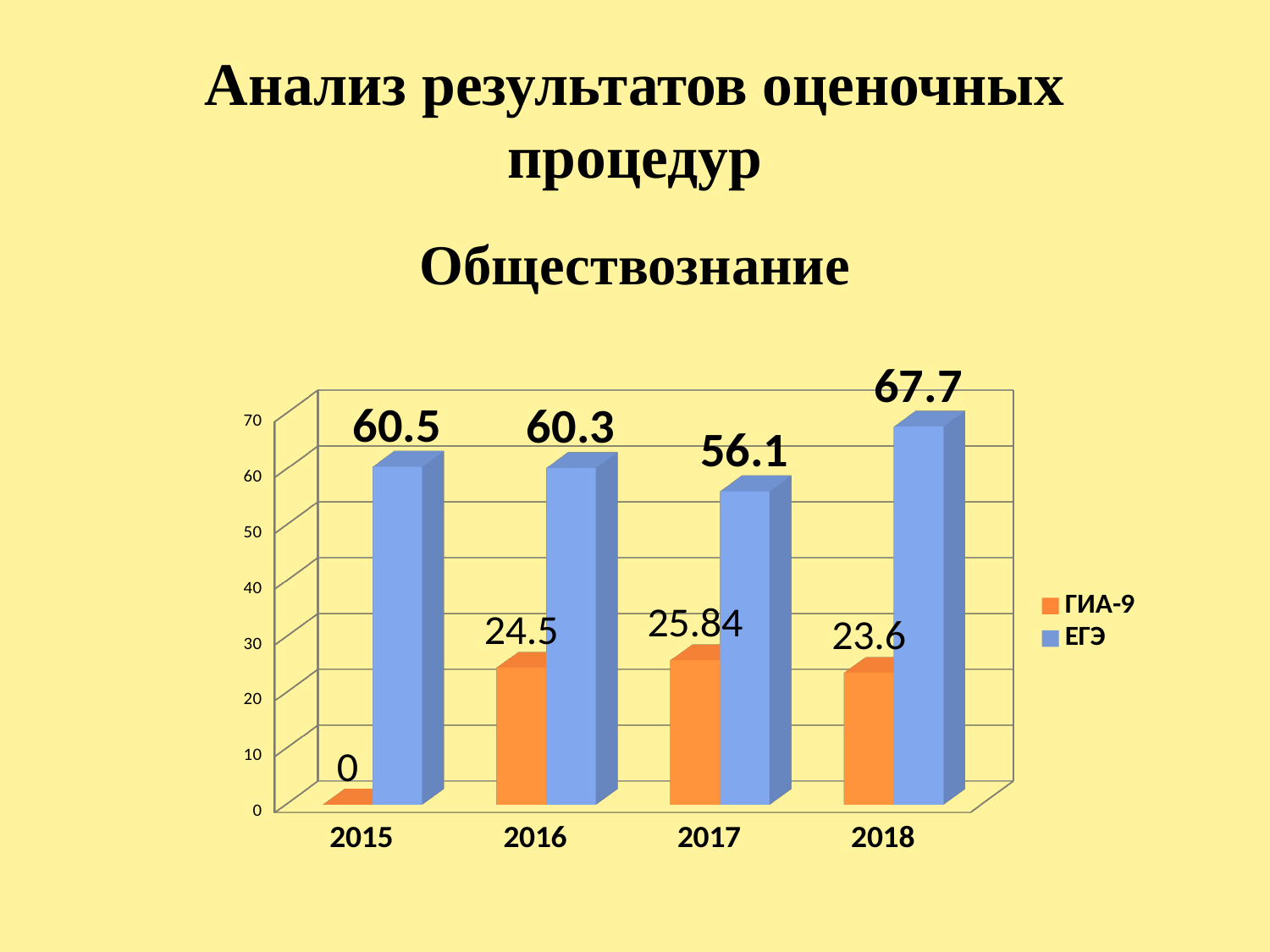
What is the difference between the ЕГЭ value and the ГИА-9 value in 2018? 44.1 What is the ГИА-9 value for 2017? 25.84 What kind of chart is shown on the slide? Bar chart Which subject is named in the subtitle above the chart? Обществознание What is the ГИА-9 value for 2015? 0 Which year has the highest ЕГЭ value? 2018 Which year has the lowest ЕГЭ value? 2017 How many series does the legend list? 2 Which year has the highest ГИА-9 value? 2017 What is the ЕГЭ value for 2018? 67.7 Which is larger, the ГИА-9 value for 2016 or for 2018? 2016 How many years are shown on the x axis? 4